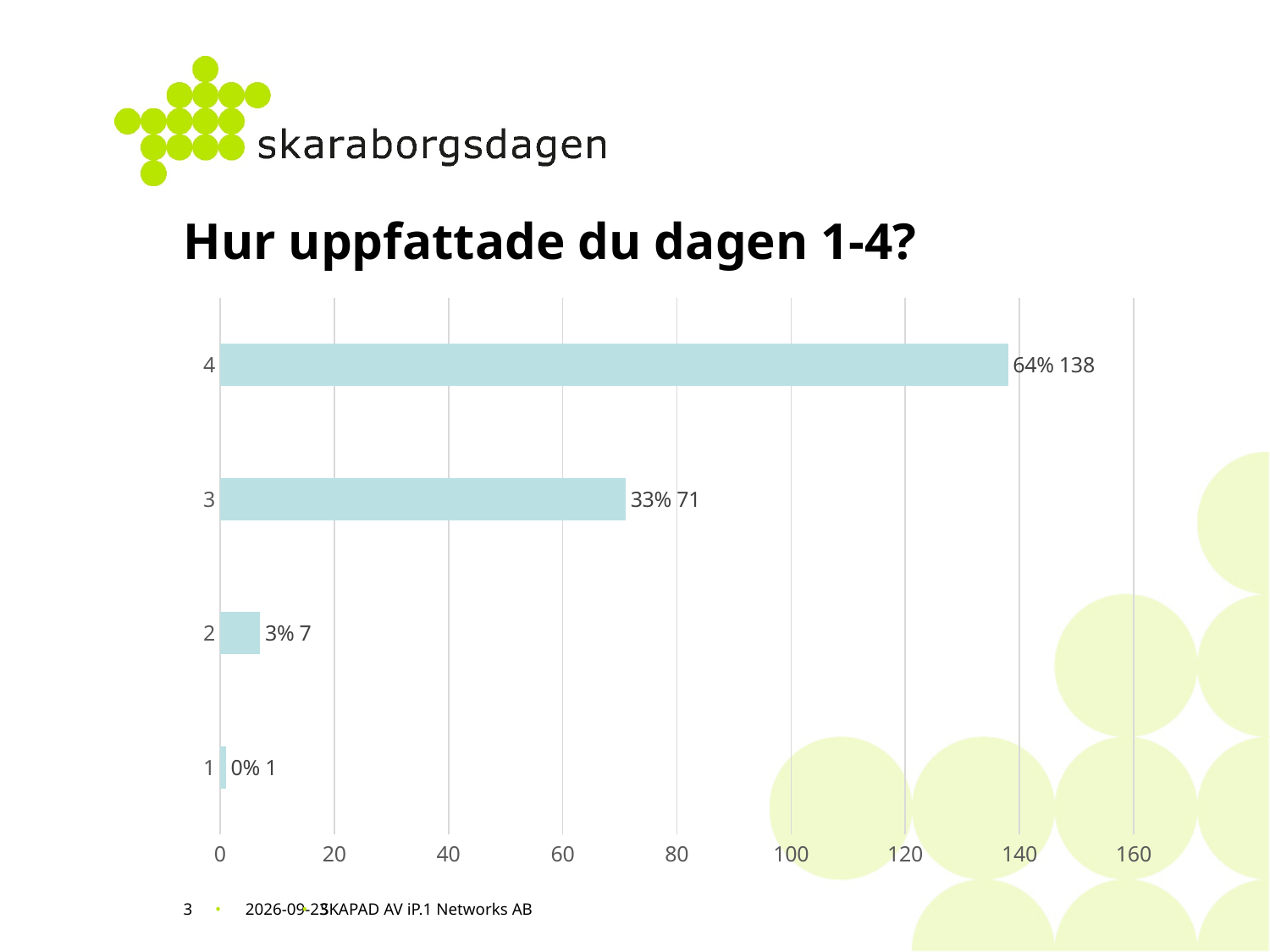
How many categories are shown in the chart? 4 What is the count for category 2? 7 What percentage is shown for category 3? 33% Which has a larger count, category 3 or category 2? 3 What is the title of the chart? Hur uppfattade du dagen 1-4? What is the count for category 4? 138 Which category has the highest count? 4 Is the value for category 4 greater or less than 120? greater What kind of chart is shown on the slide? bar chart Which category has the lowest count? 1 What percentage is shown for category 1? 0% What is the difference in count between category 4 and category 3? 67